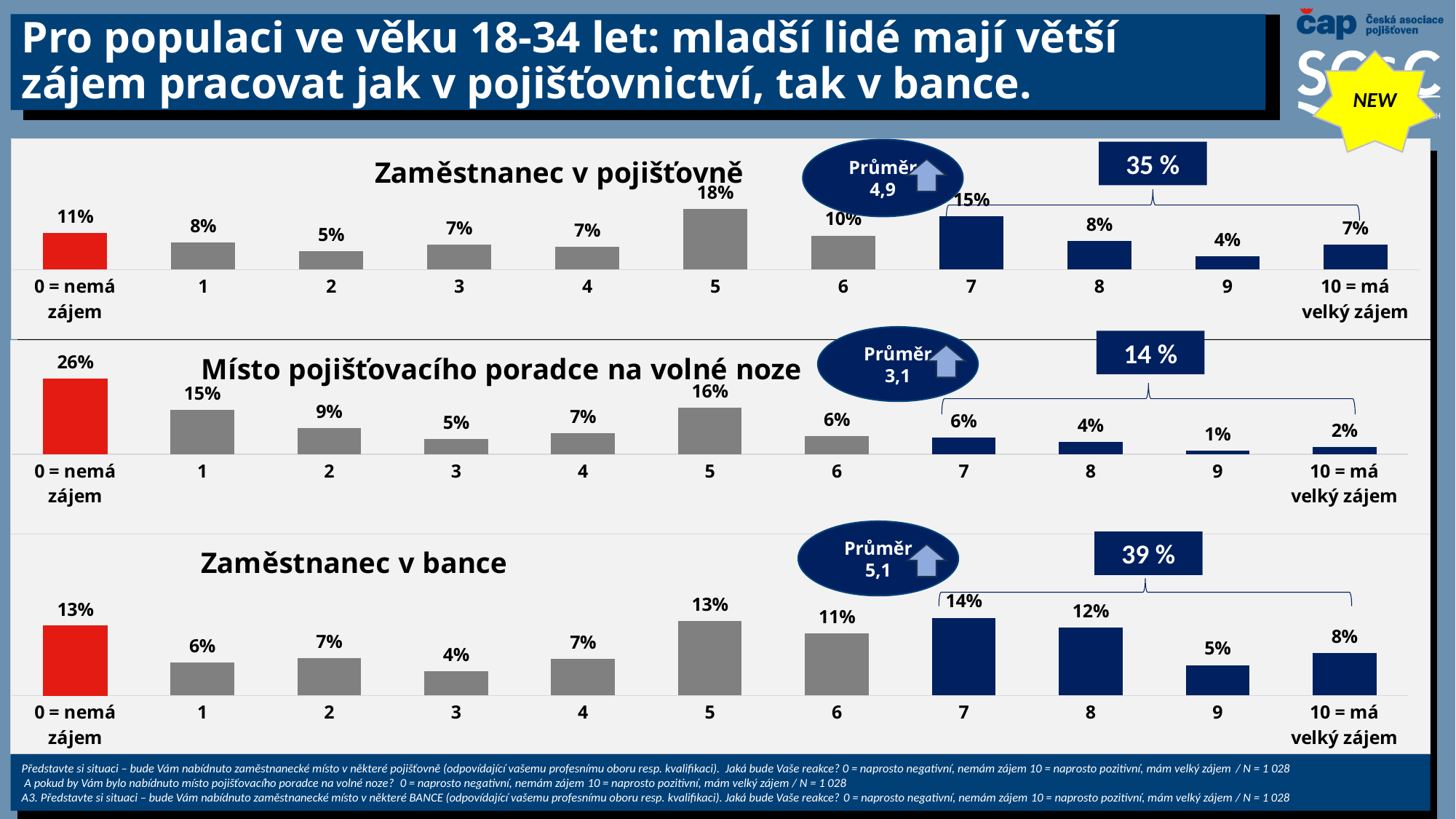
In the 'Zaměstnanec v pojišťovně' chart, which category has the highest value? 5 In the 'Zaměstnanec v bance' chart, which is larger: the value for category 7 or the value for category 6? category 7 What average (Průměr) is shown for the 'Zaměstnanec v bance' chart? 5,1 In the 'Místo pojišťovacího poradce na volné noze' chart, what is the value for '0 = nemá zájem'? 26% In the 'Zaměstnanec v pojišťovně' chart, which category has the lowest value? 9 In the 'Zaměstnanec v bance' chart, what is the value for category 8? 12% In the 'Zaměstnanec v pojišťovně' chart, what is the value for category 5? 18% In the 'Místo pojišťovacího poradce na volné noze' chart, what is the difference between the values for category 1 and category 2? 6% In the 'Zaměstnanec v bance' chart, what is the difference between the values for category 7 and category 9? 9% How many categories does the 'Zaměstnanec v bance' chart show? 11 In the 'Místo pojišťovacího poradce na volné noze' chart, which category has the lowest value? 9 What type of chart is 'Zaměstnanec v pojišťovně'? bar chart